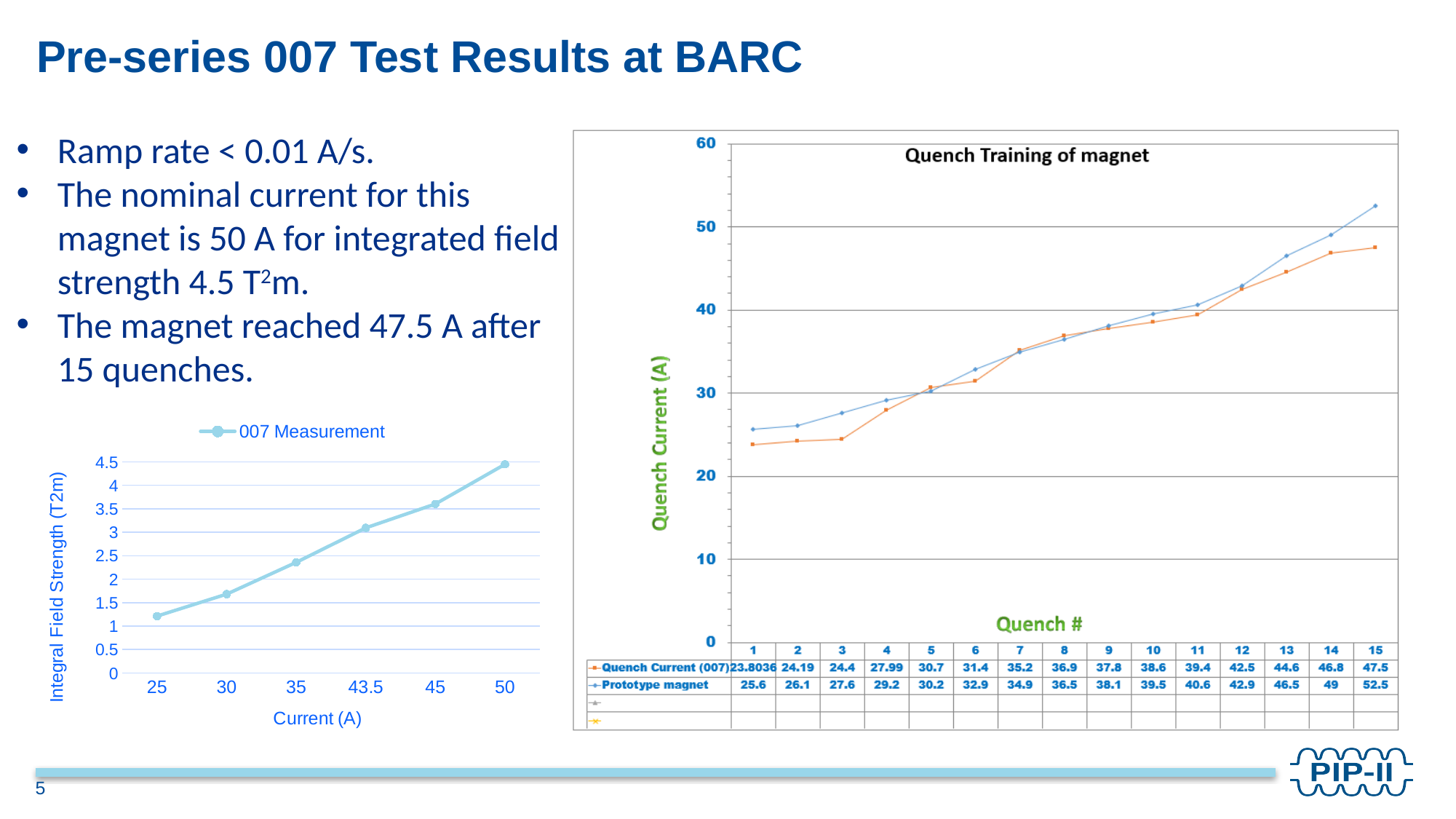
What kind of chart is the 007 Measurement chart on the left? Line chart In the Quench Training of magnet chart, how many quench numbers are plotted on the x axis? 15 In the Quench Training of magnet chart, what is the difference between the Prototype magnet and Quench Current (007) values at quench 15? 5 In the Quench Training of magnet chart, how many named data series are listed in the data table? 2 In the Quench Training of magnet chart, what is the Prototype magnet value at quench 15? 52.5 In the Quench Training of magnet chart, what is the difference between the Prototype magnet and Quench Current (007) values at quench 14? 2.2 In the Quench Training of magnet chart, what is the Quench Current (007) at quench 15? 47.5 In the Quench Training of magnet chart, at quench 5, which is larger: Quench Current (007) or Prototype magnet? Quench Current (007) In the 007 Measurement chart, does the Integral Field Strength rise or fall as Current increases? Rises In the Quench Training of magnet chart, what is the Quench Current (007) at quench 1? 23.8036 In the Quench Training of magnet chart, at which quench number is the Quench Current (007) highest? 15 In the 007 Measurement chart, is the Integral Field Strength at 50 A greater or less than 4? greater